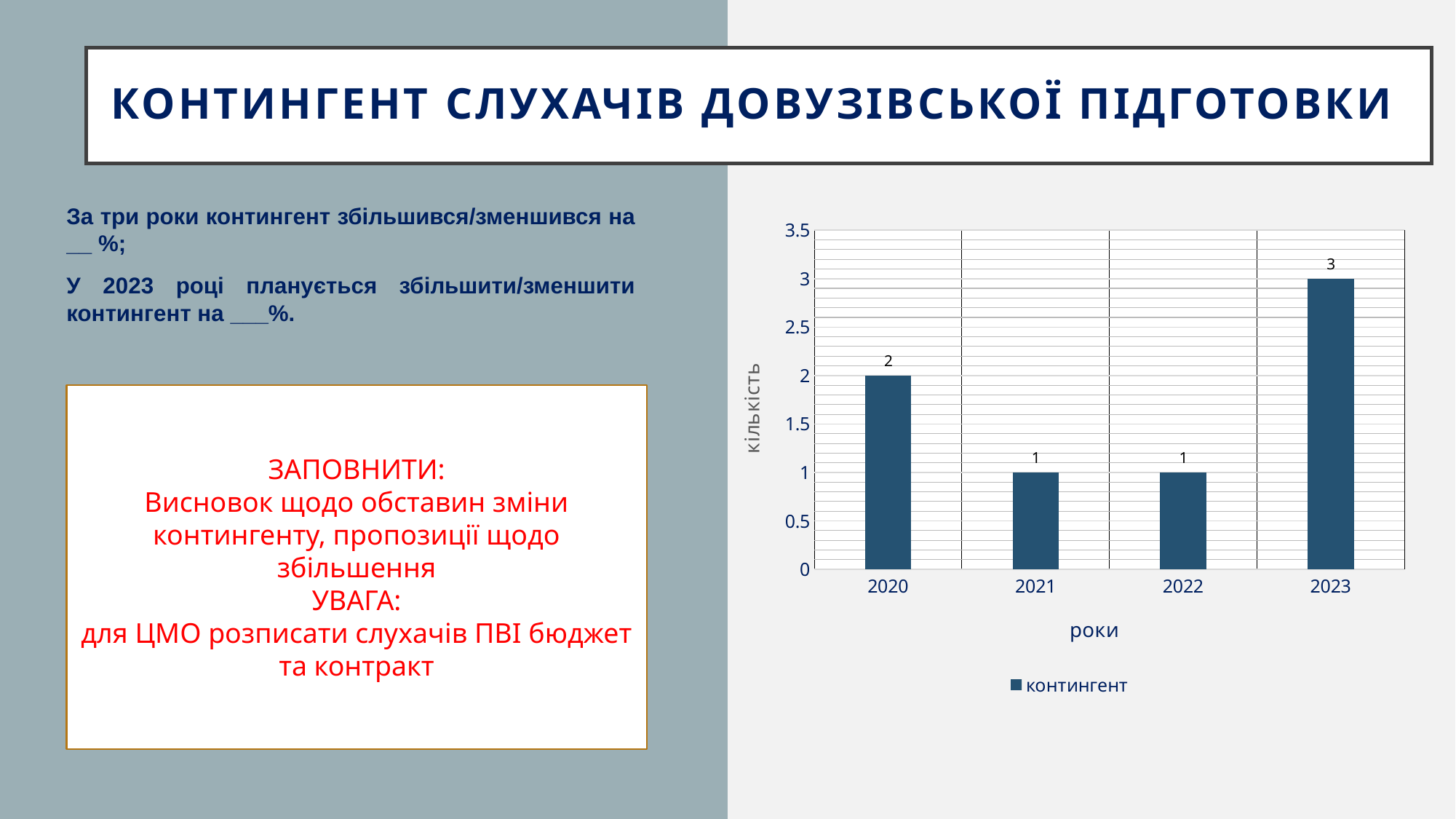
What is the difference between the values for 2023 and 2020? 1 Which is larger, the value for 2020 or the value for 2022? 2020 What is the value for 2020? 2 What is the label of the y axis? кількість How many series does the legend list? 1 What is the value for 2023? 3 Which year has the highest value? 2023 What series name is shown in the legend? контингент How many years are shown on the x axis? 4 What is the value for 2021? 1 What kind of chart is shown? bar chart Is the value for 2023 greater or less than 2.5? greater